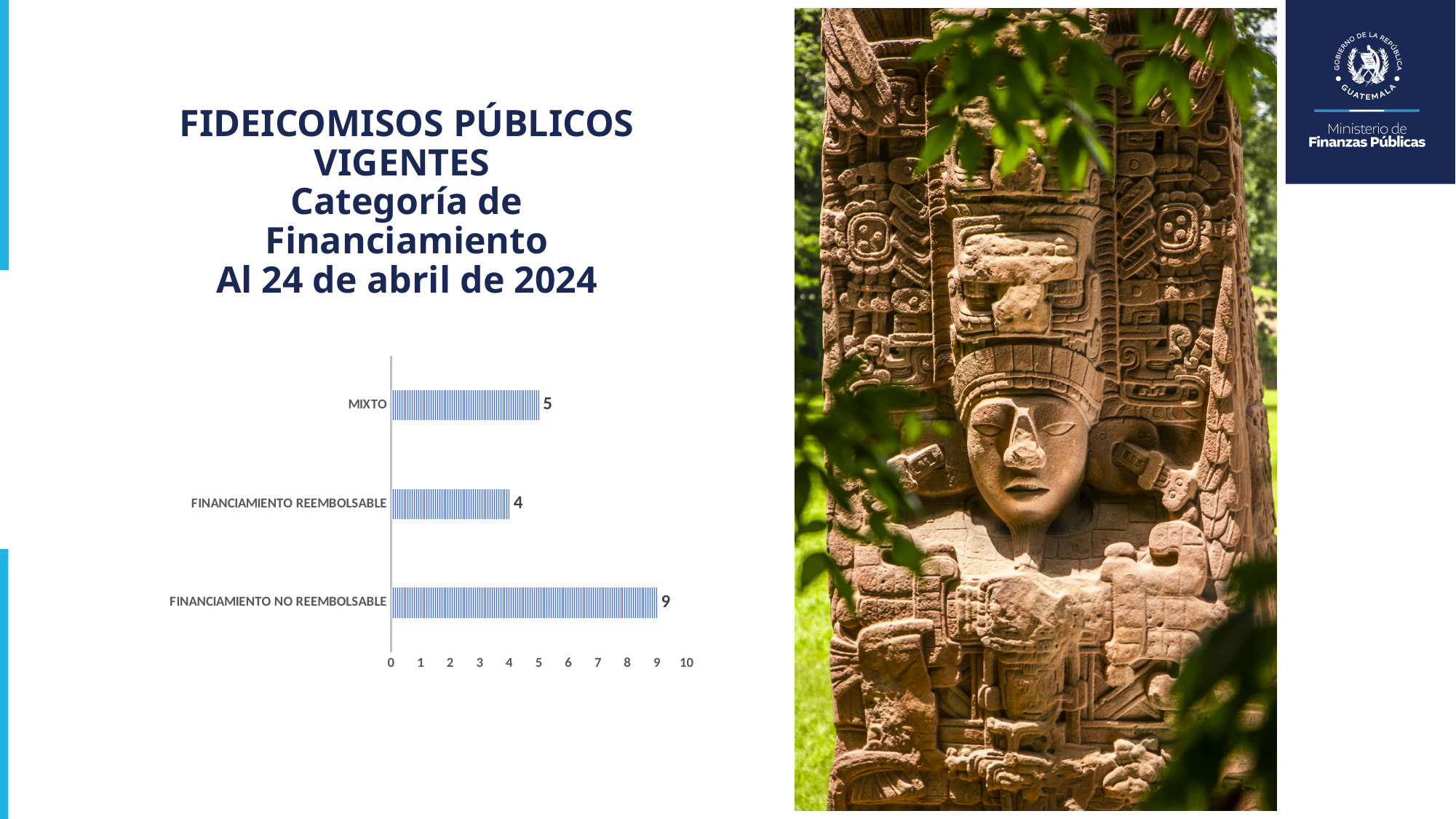
What is the value for FINANCIAMIENTO NO REEMBOLSABLE? 9 What is the value for FINANCIAMIENTO REEMBOLSABLE? 4 What is the value for MIXTO? 5 Which is larger, the value for MIXTO or the value for FINANCIAMIENTO REEMBOLSABLE? MIXTO What is the difference between the values for MIXTO and FINANCIAMIENTO REEMBOLSABLE? 1 How many categories are shown in the chart? 3 What kind of chart is shown on the slide? Bar chart Which category has the highest value? FINANCIAMIENTO NO REEMBOLSABLE What is the difference between the values for FINANCIAMIENTO NO REEMBOLSABLE and MIXTO? 4 Which category has the lowest value? FINANCIAMIENTO REEMBOLSABLE Is the value for FINANCIAMIENTO NO REEMBOLSABLE greater or less than 8? greater What is the maximum value shown on the chart's axis? 10